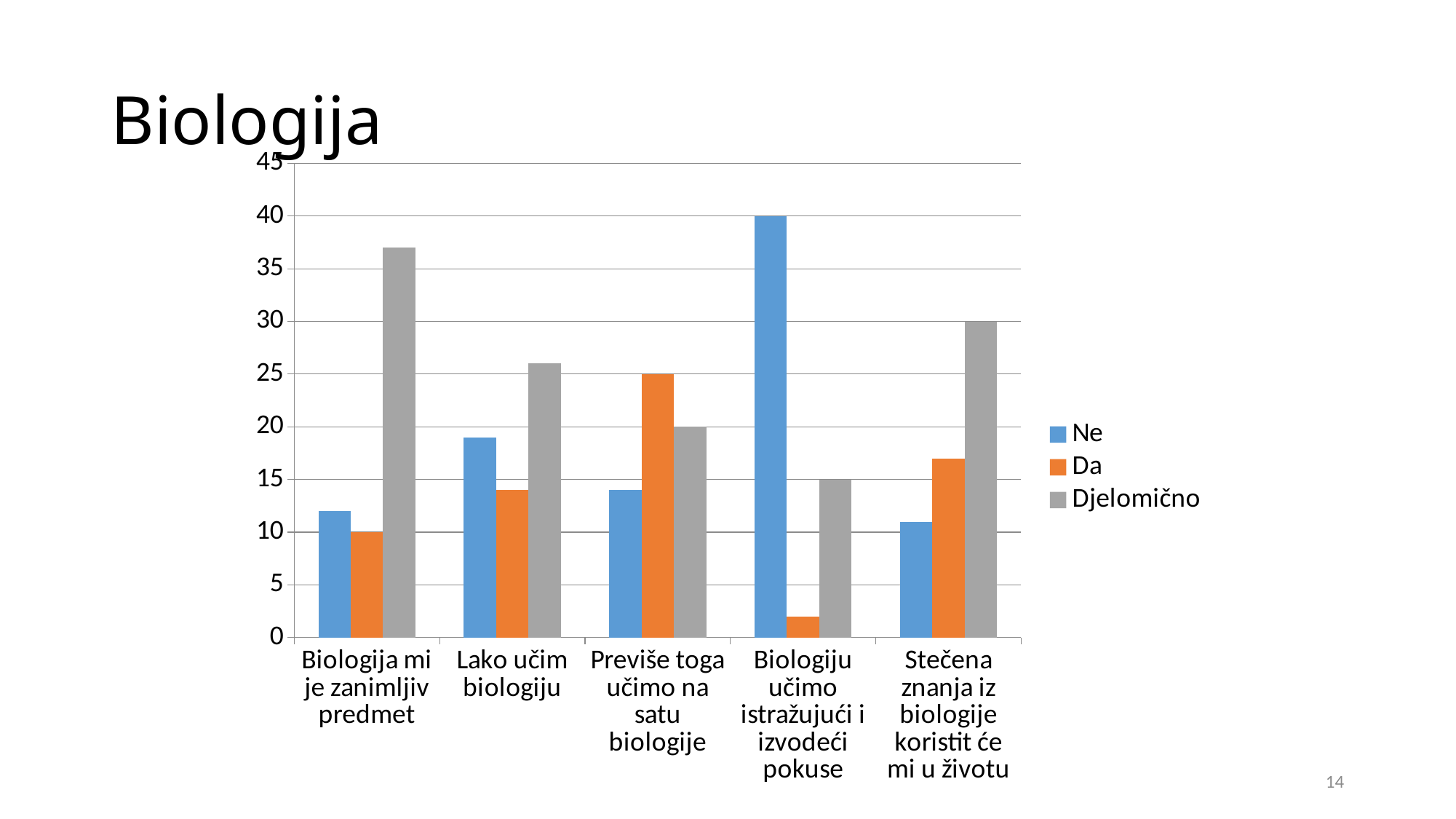
For "Lako učim biologiju", which is larger: Ne or Da? Ne What is the value of Djelomično for "Stečena znanja iz biologije koristit će mi u životu"? 30 What is the value of Da for "Previše toga učimo na satu biologije"? 25 Which category has the lowest Da value? Biologiju učimo istražujući i izvodeći pokuse What is the difference between the Da and Djelomično values for "Previše toga učimo na satu biologije"? 5 Which category has the highest Ne value? Biologiju učimo istražujući i izvodeći pokuse What is the value of Djelomično for "Biologiju učimo istražujući i izvodeći pokuse"? 15 What is the value of Ne for "Biologiju učimo istražujući i izvodeći pokuse"? 40 How many series does the legend list? 3 Is the Djelomično value for "Biologija mi je zanimljiv predmet" greater or less than 35? greater How many categories are shown on the x axis? 5 What kind of chart is shown on the slide? bar chart